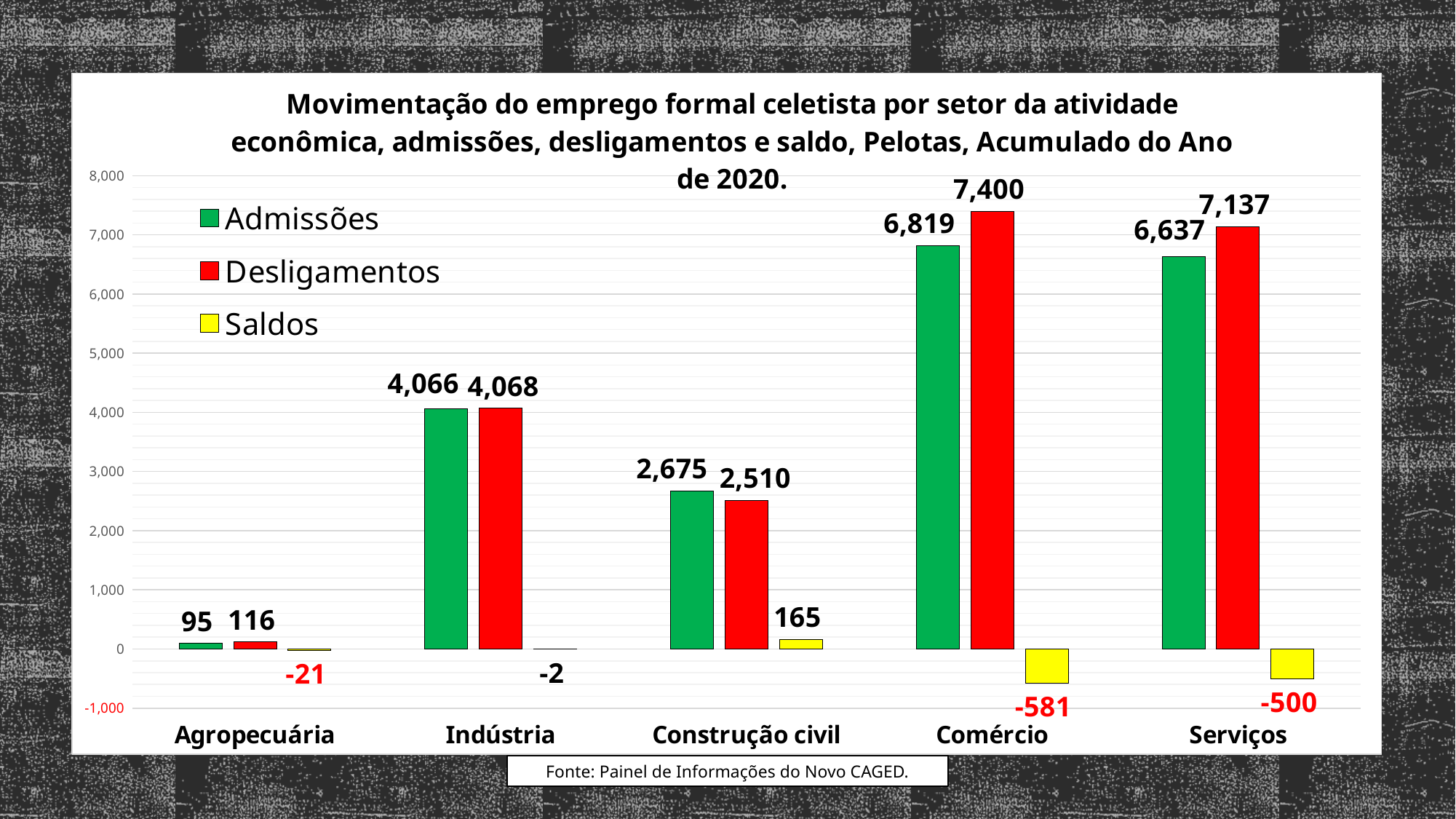
What is the value of Admissões for Comércio? 6,819 What kind of chart is shown on the slide? Bar chart Which is larger for Construção civil, Admissões or Desligamentos? Admissões What is the Saldos value for Construção civil? 165 What is the value of Desligamentos for Serviços? 7,137 How many series does the legend list? 3 What is the difference between Desligamentos and Admissões for Serviços? 500 What is the Saldos value for Comércio? -581 Which colour represents the Saldos series in the legend? Yellow Which sector has the lowest Admissões value? Agropecuária How many sectors are shown on the x axis? 5 Which sector has the highest Desligamentos value? Comércio